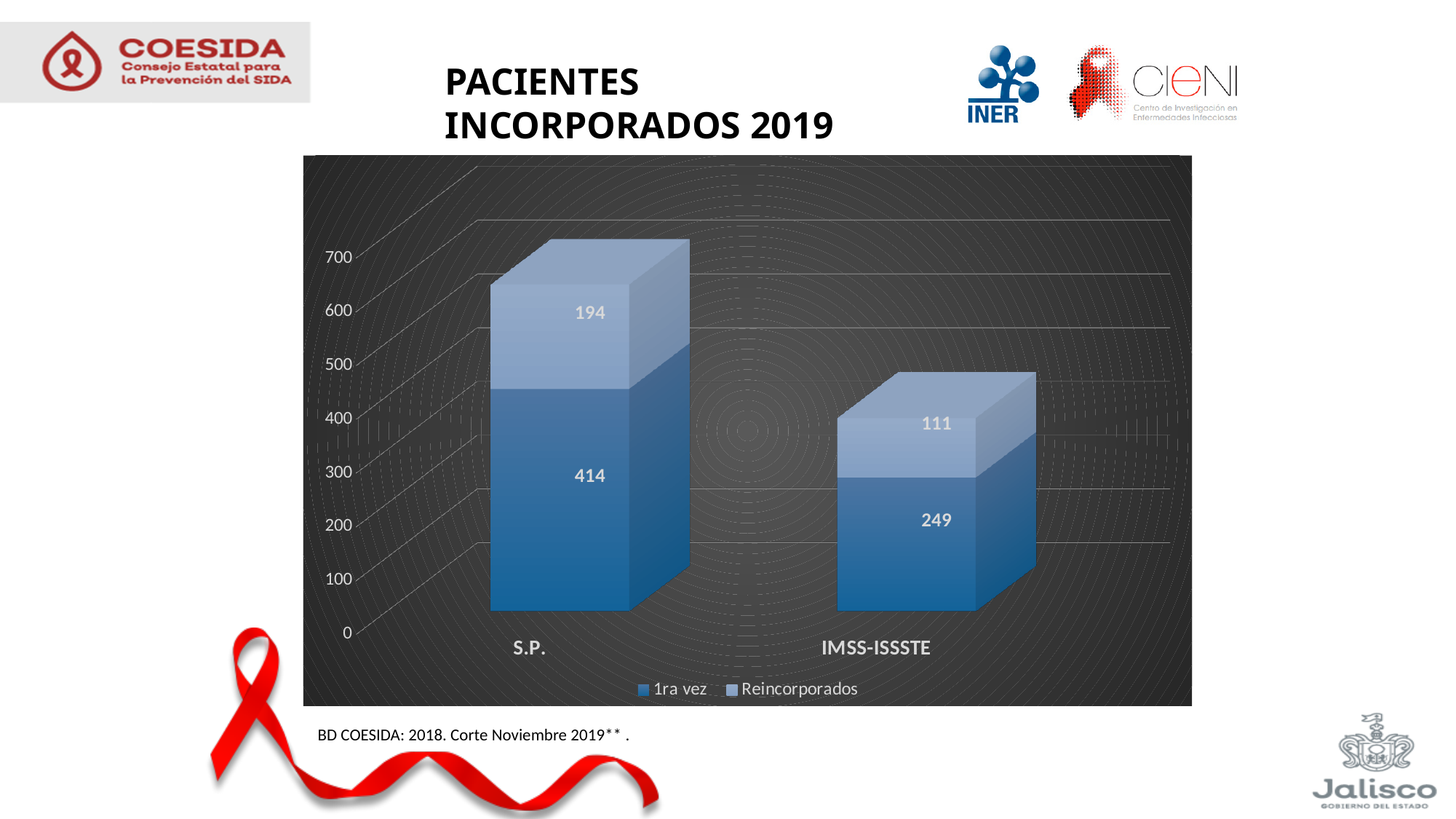
What is the difference between the '1ra vez' values for S.P. and IMSS-ISSSTE? 165 What is the value for 'Reincorporados' in the S.P. category? 194 What is the value for '1ra vez' in the IMSS-ISSSTE category? 249 How many series does the legend list? 2 What is the value for '1ra vez' in the S.P. category? 414 Which category has the higher '1ra vez' value? S.P. Which category has the lower 'Reincorporados' value? IMSS-ISSSTE What is the value for 'Reincorporados' in the IMSS-ISSSTE category? 111 What is the total of the stacked bar for S.P.? 608 How many categories are shown on the x axis? 2 What is the total of the stacked bar for IMSS-ISSSTE? 360 What kind of chart is shown on the slide? Stacked bar chart